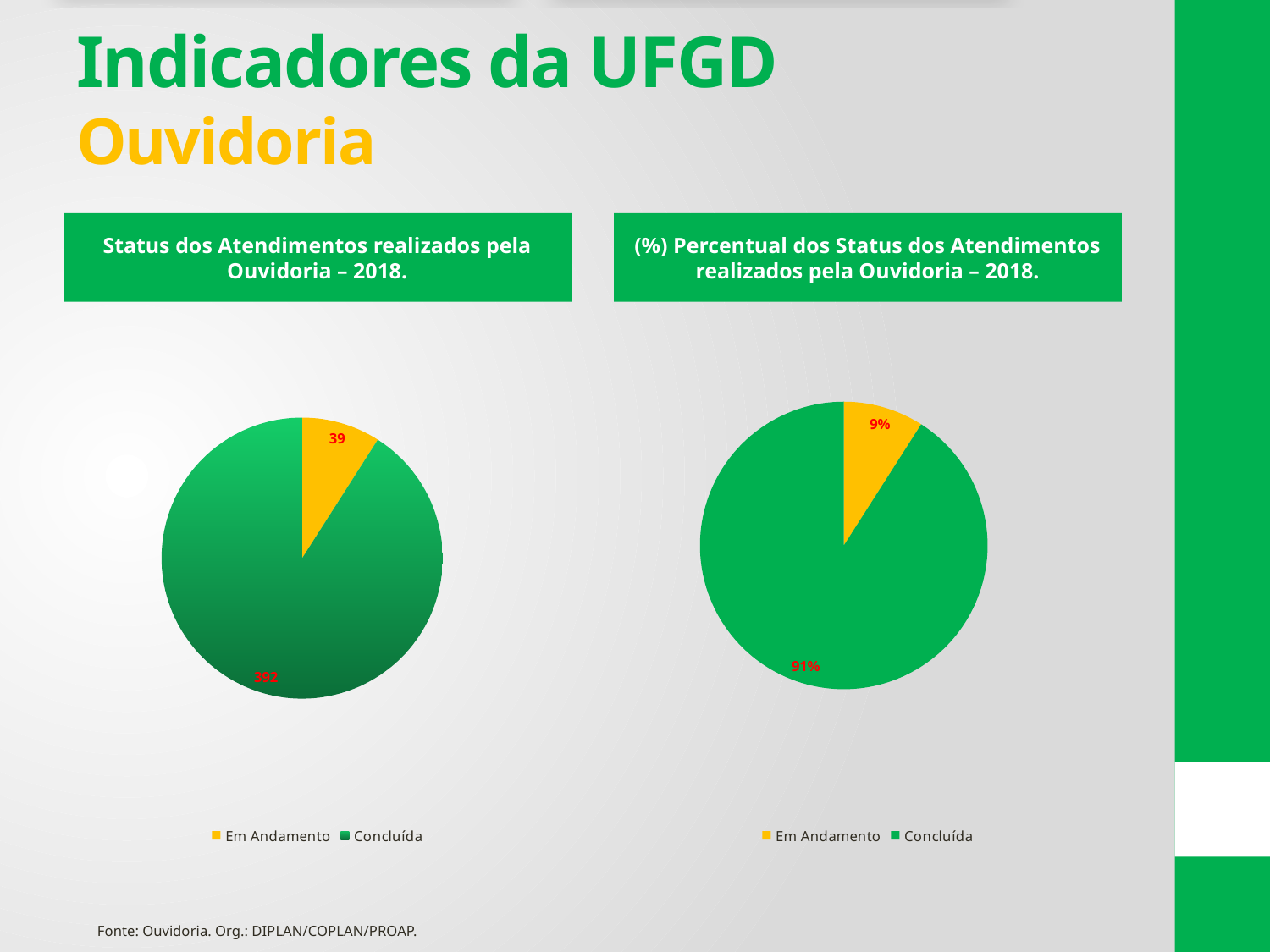
In the left chart (Status dos Atendimentos realizados pela Ouvidoria – 2018), what is the difference between Concluída and Em Andamento? 353 In the left chart (Status dos Atendimentos realizados pela Ouvidoria – 2018), what is the value for Concluída? 392 What type of chart is the left chart (Status dos Atendimentos realizados pela Ouvidoria – 2018)? Pie chart In the left chart (Status dos Atendimentos realizados pela Ouvidoria – 2018), what is the value for Em Andamento? 39 In the right chart ((%) Percentual dos Status dos Atendimentos realizados pela Ouvidoria – 2018), which is larger, Em Andamento or Concluída? Concluída In the right chart ((%) Percentual dos Status dos Atendimentos realizados pela Ouvidoria – 2018), what percentage is shown for Em Andamento? 9% How many categories does the legend of the right chart ((%) Percentual dos Status dos Atendimentos realizados pela Ouvidoria – 2018) list? 2 In the left chart (Status dos Atendimentos realizados pela Ouvidoria – 2018), what colour represents Em Andamento? Yellow In the left chart (Status dos Atendimentos realizados pela Ouvidoria – 2018), what is the total of Em Andamento and Concluída? 431 In the right chart ((%) Percentual dos Status dos Atendimentos realizados pela Ouvidoria – 2018), which category has the smallest slice? Em Andamento In the left chart (Status dos Atendimentos realizados pela Ouvidoria – 2018), which category has the largest slice? Concluída In the right chart ((%) Percentual dos Status dos Atendimentos realizados pela Ouvidoria – 2018), what percentage is shown for Concluída? 91%